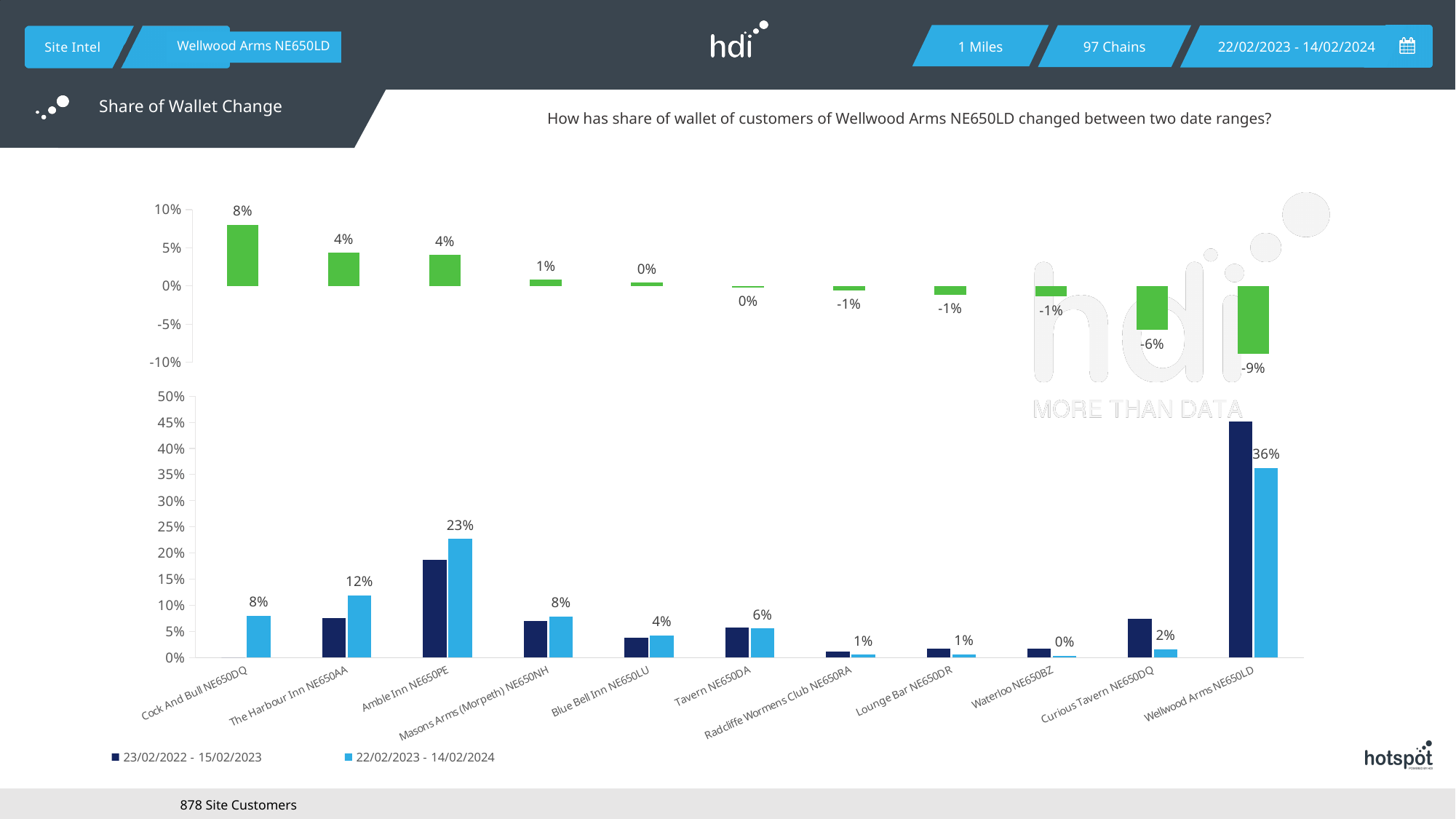
In the bottom chart, is the 23/02/2022 - 15/02/2023 value for Wellwood Arms NE650LD greater or less than 40%? greater How many series does the legend of the bottom chart list? 2 In the bottom chart, what is the share of wallet for Amble Inn NE650PE in the 22/02/2023 - 14/02/2024 period? 23% In the top chart, what is the share of wallet change for Wellwood Arms NE650LD? -9% In the bottom chart, what is the share of wallet for Wellwood Arms NE650LD in the 22/02/2023 - 14/02/2024 period? 36% In the top chart, what is the share of wallet change for Cock And Bull NE650DQ? 8% In the bottom chart, which is larger for The Harbour Inn NE650AA: the 23/02/2022 - 15/02/2023 value or the 22/02/2023 - 14/02/2024 value? 22/02/2023 - 14/02/2024 How many venues are shown on the x axis of the bottom chart? 11 In the top chart, what is the difference between the change for Cock And Bull NE650DQ and the change for Curious Tavern NE650DQ? 14% In the top chart, which venue has the lowest share of wallet change? Wellwood Arms NE650LD What kind of chart is the bottom chart? Bar chart In the top chart, which venue has the highest share of wallet change? Cock And Bull NE650DQ